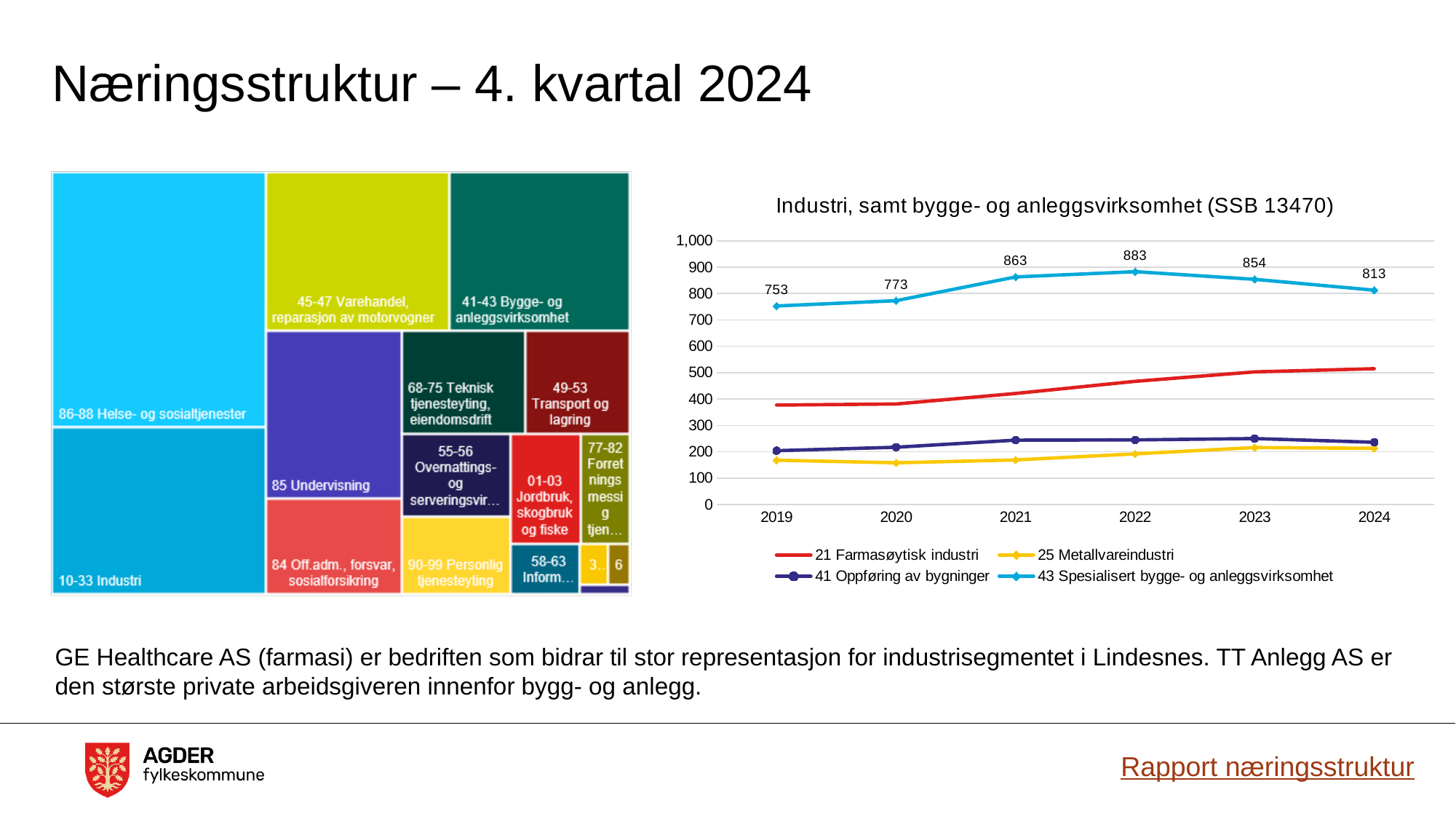
In the chart titled 'Industri, samt bygge- og anleggsvirksomhet (SSB 13470)', is the value for '25 Metallvareindustri' in 2020 greater or less than 200? less In the chart titled 'Industri, samt bygge- og anleggsvirksomhet (SSB 13470)', what is the value for '43 Spesialisert bygge- og anleggsvirksomhet' in 2022? 883 In the chart titled 'Industri, samt bygge- og anleggsvirksomhet (SSB 13470)', in which year does '43 Spesialisert bygge- og anleggsvirksomhet' have its lowest value? 2019 In the chart titled 'Industri, samt bygge- og anleggsvirksomhet (SSB 13470)', what is the difference between the 2022 and 2019 values for '43 Spesialisert bygge- og anleggsvirksomhet'? 130 In the chart titled 'Industri, samt bygge- og anleggsvirksomhet (SSB 13470)', how many series does the legend list? 4 What kind of chart is the one titled 'Industri, samt bygge- og anleggsvirksomhet (SSB 13470)'? line chart In the chart titled 'Industri, samt bygge- og anleggsvirksomhet (SSB 13470)', which year has the larger value for '43 Spesialisert bygge- og anleggsvirksomhet', 2021 or 2024? 2021 In the chart titled 'Industri, samt bygge- og anleggsvirksomhet (SSB 13470)', does the value for '21 Farmasøytisk industri' rise or fall from 2019 to 2024? rises In the chart titled 'Industri, samt bygge- og anleggsvirksomhet (SSB 13470)', what is the value for '43 Spesialisert bygge- og anleggsvirksomhet' in 2019? 753 In the chart titled 'Industri, samt bygge- og anleggsvirksomhet (SSB 13470)', how many years are shown on the x axis? 6 In the chart titled 'Industri, samt bygge- og anleggsvirksomhet (SSB 13470)', in which year does '43 Spesialisert bygge- og anleggsvirksomhet' reach its highest value? 2022